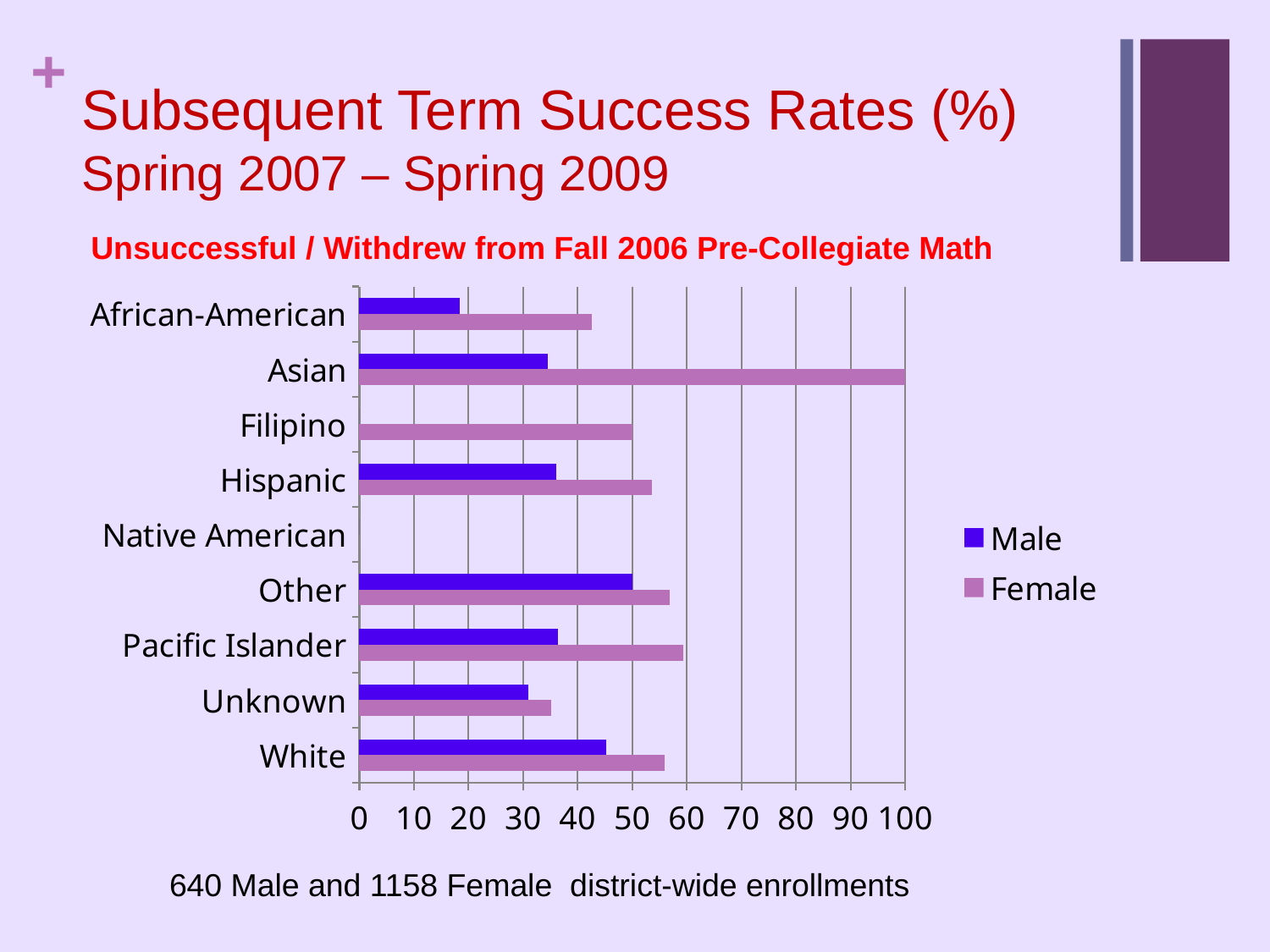
Which category shows no bars for either Male or Female? Native American How many ethnic categories are shown on the chart? 9 Is the Female value for Unknown greater or less than 40? less Is the Male value for White greater or less than 40? greater Is the Male value for African-American greater or less than 20? less How many series does the legend list? 2 What is the Female value for Asian? 100 Which category has the highest Female value? Asian What kind of chart is shown on the slide? bar chart For Asian, which is larger, the Male value or the Female value? Female Which category has the lowest Male value among those with a Male bar? African-American